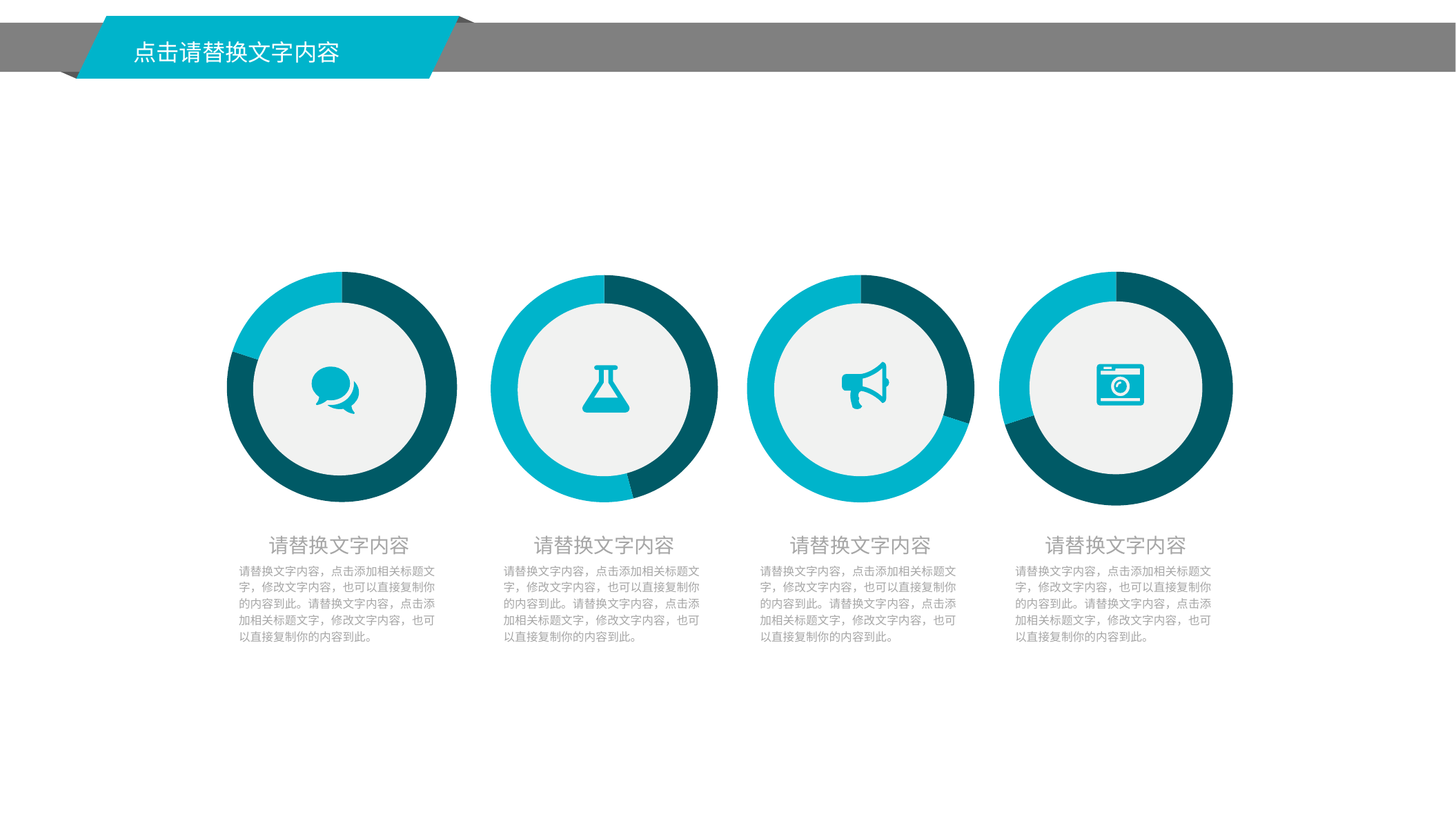
In the leftmost donut chart, which segment is larger, the dark teal one or the light cyan one? dark teal Which donut chart has the largest light cyan share? the third from the left How many segments does the leftmost donut chart have? 2 In the second donut chart from the left, which segment is larger, the dark teal one or the light cyan one? light cyan In the rightmost donut chart, which segment is larger, the dark teal one or the light cyan one? dark teal How many donut charts are on the slide? 4 How many colours are used for the segments in each donut chart? 2 What icon is shown in the centre of the leftmost donut chart? speech bubbles What kind of chart is the leftmost chart on the slide? donut (pie) chart